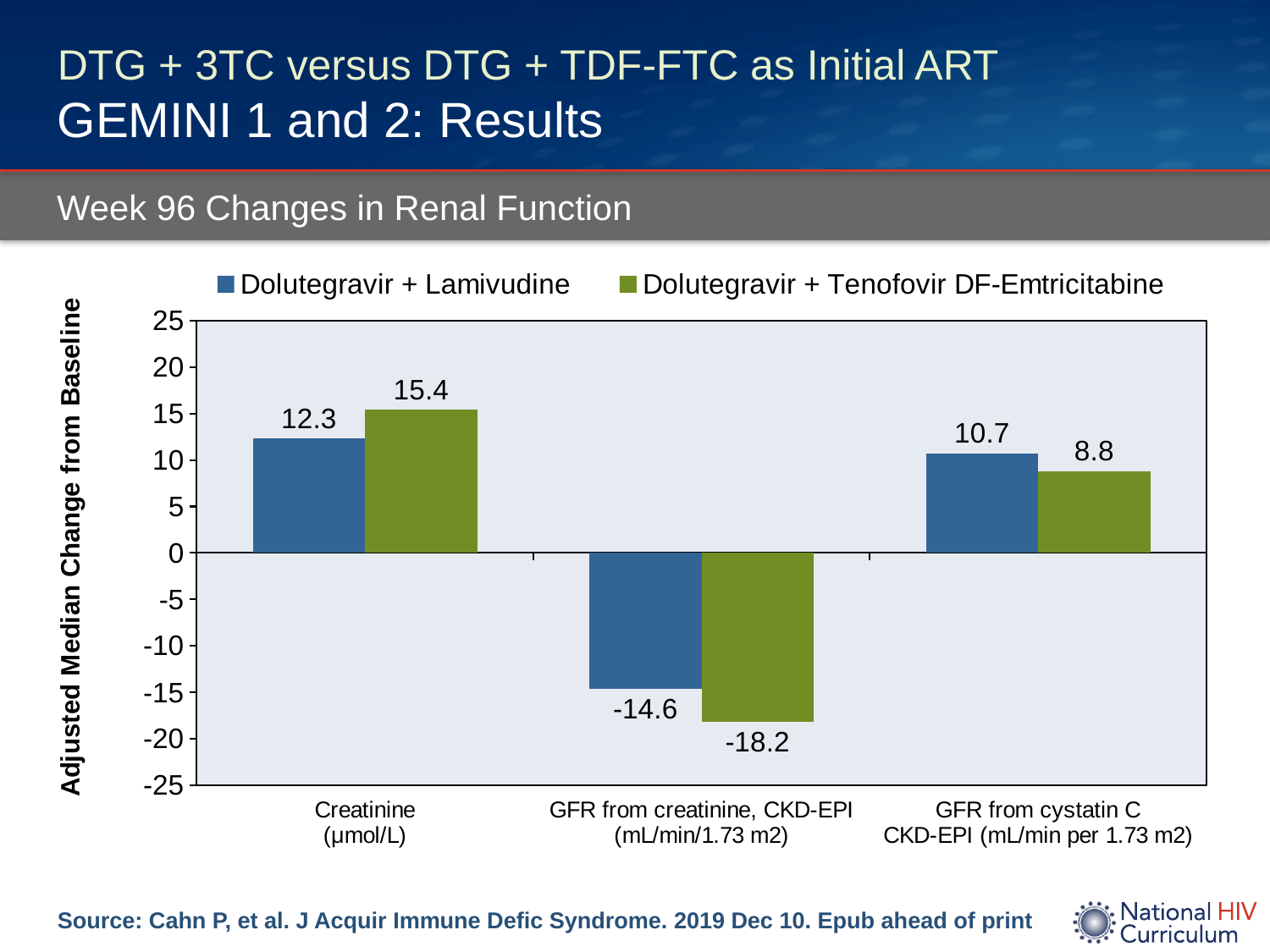
Which category has the lowest value for Dolutegravir + Lamivudine? GFR from creatinine, CKD-EPI How many series does the legend list? 2 For GFR from cystatin C CKD-EPI, which series has the larger value? Dolutegravir + Lamivudine What is the difference between the two series' values for creatinine (µmol/L)? 3.1 Which category has the highest value for Dolutegravir + Tenofovir DF-Emtricitabine? Creatinine What is the value for Dolutegravir + Tenofovir DF-Emtricitabine for GFR from creatinine, CKD-EPI? -18.2 What is the adjusted median change from baseline in creatinine (µmol/L) for Dolutegravir + Lamivudine? 12.3 How many categories are shown on the x axis? 3 What is the adjusted median change from baseline in creatinine (µmol/L) for Dolutegravir + Tenofovir DF-Emtricitabine? 15.4 What kind of chart is shown on the slide? Bar chart What is the value for Dolutegravir + Lamivudine for GFR from cystatin C CKD-EPI? 10.7 What is the difference between the Dolutegravir + Lamivudine and Dolutegravir + Tenofovir DF-Emtricitabine values for GFR from creatinine, CKD-EPI? 3.6